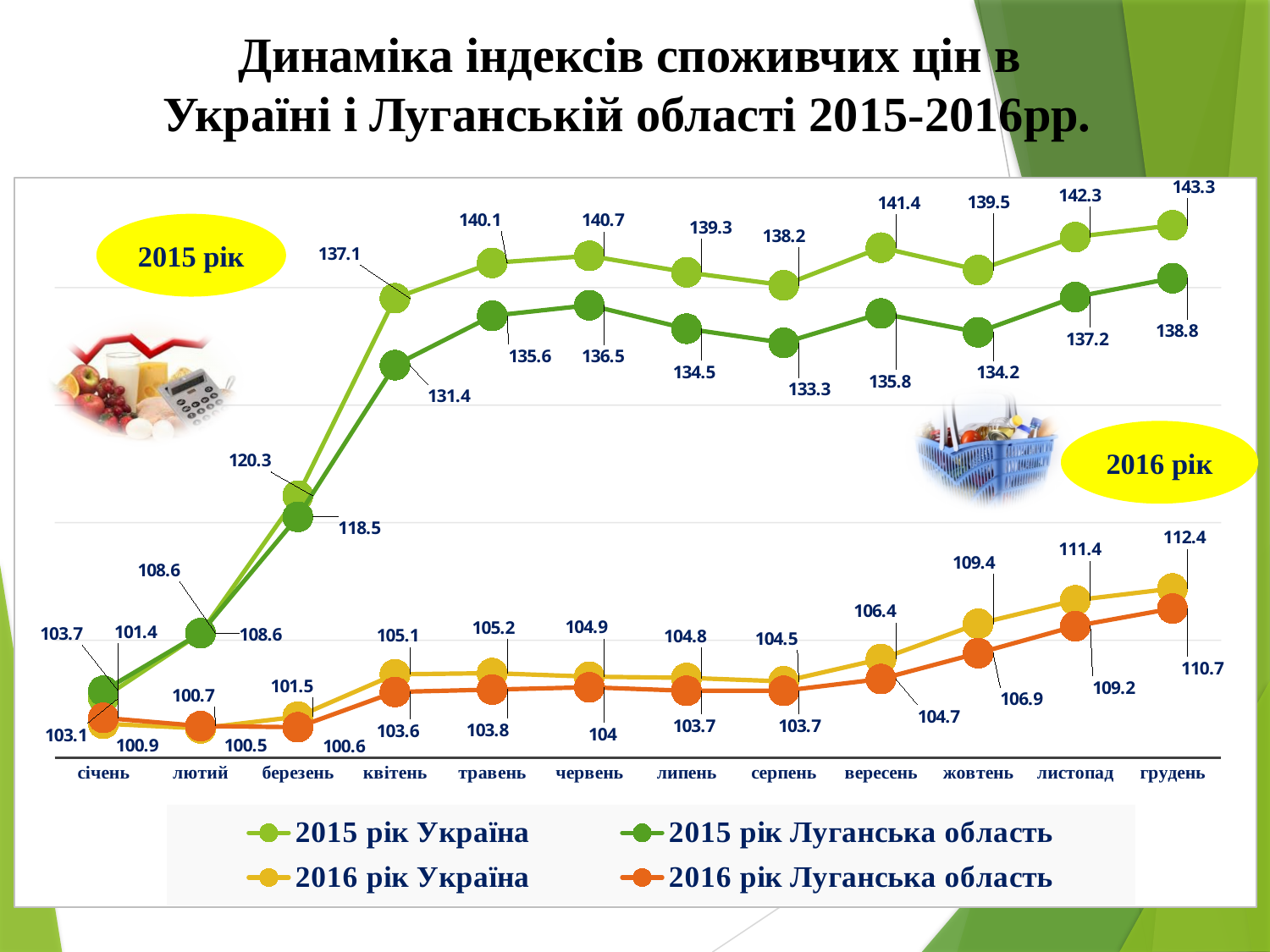
Which is larger in грудень: 2016 рік Україна or 2016 рік Луганська область? 2016 рік Україна Does the 2016 рік Україна series rise or fall from вересень to грудень? rise What is the difference between 2015 рік Україна and 2015 рік Луганська область in квітень? 5.7 What type of chart is shown on the slide? line chart In which month does 2015 рік Україна reach its highest value? грудень What is the highest value of the 2016 рік Луганська область series? 110.7 How many months are shown along the x axis? 12 What is the value for 2016 рік Луганська область in вересень? 104.7 What is the value for 2015 рік Луганська область in червень? 136.5 What is the value for 2016 рік Україна in жовтень? 109.4 How many series does the legend list? 4 What is the value for 2015 рік Україна in квітень? 137.1